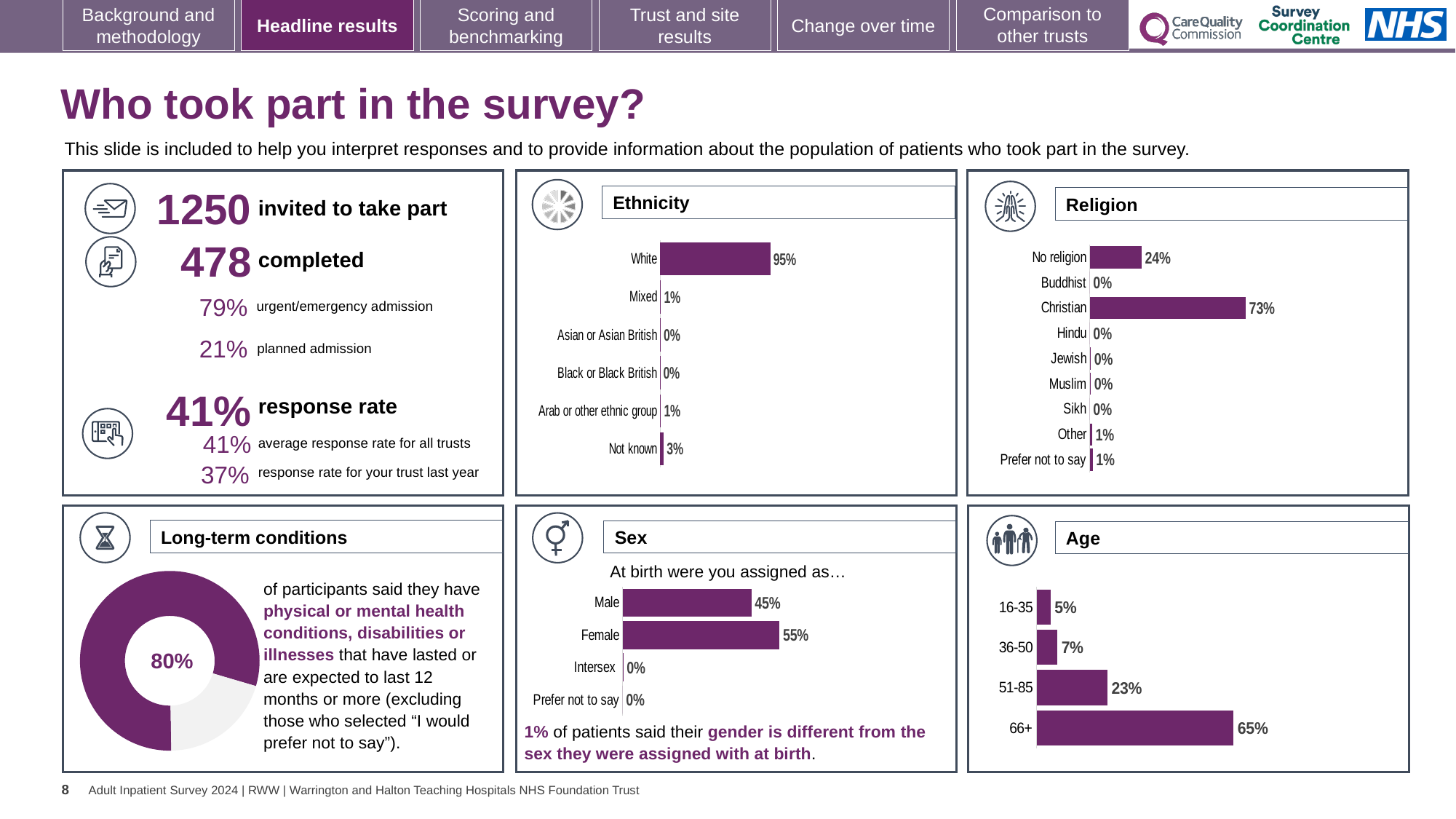
In the Ethnicity chart, how many categories are shown? 6 In the Ethnicity chart, what percentage of participants were White? 95% What kind of chart is the Long-term conditions chart? doughnut chart In the Ethnicity chart, which category has the highest value? White In the Age chart, what percentage of participants were aged 66+? 65% In the Religion chart, how many categories are shown? 9 In the Age chart, do the values rise or fall as the age groups get older? rise In the Age chart, which age group has the lowest value? 16-35 In the Sex chart, what is the difference between the Female and Male values? 10% In the Religion chart, what is the difference between the Christian and No religion values? 49% In the Sex chart, which is larger, Male or Female? Female In the Religion chart, what percentage of participants were Christian? 73%